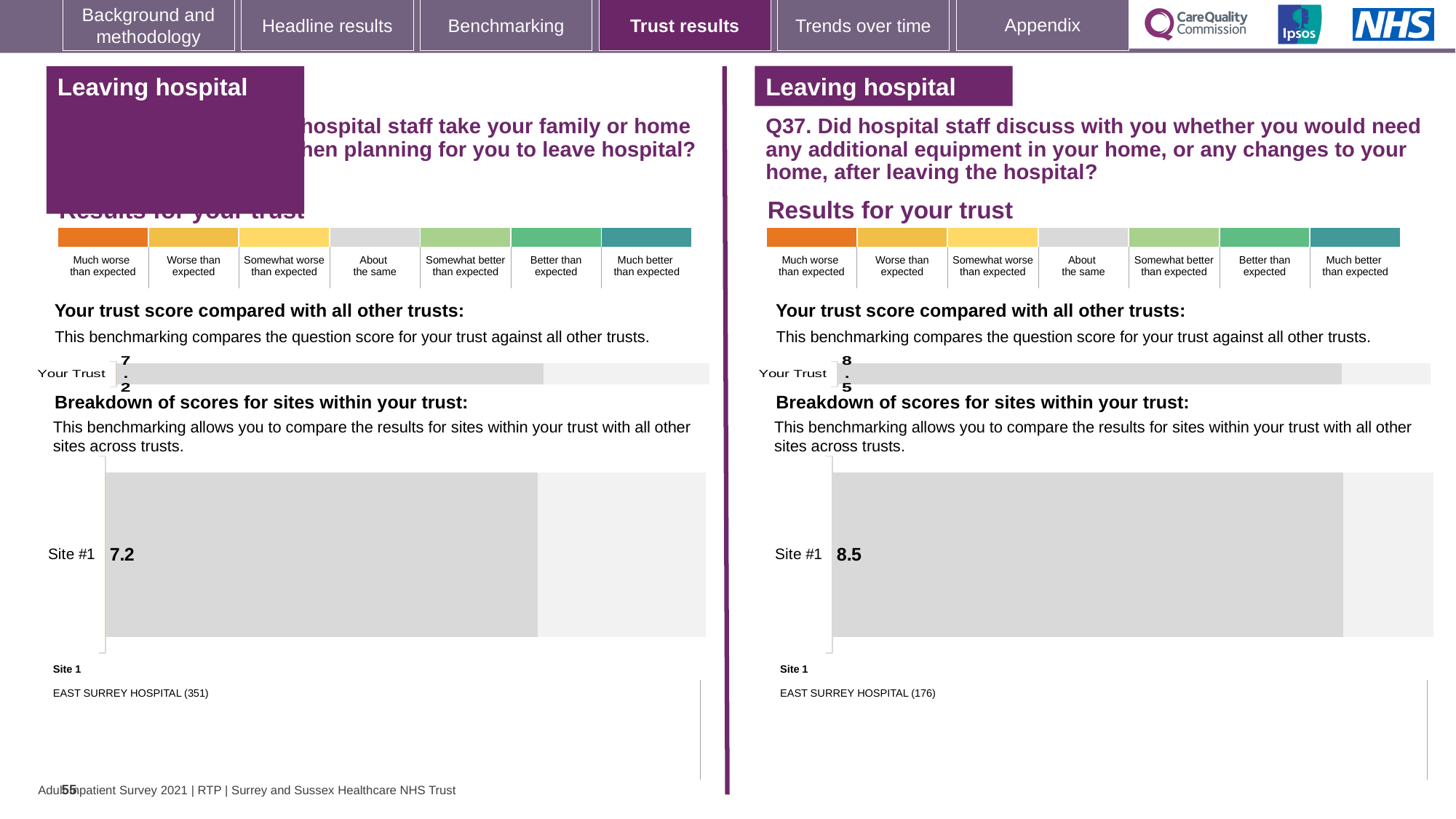
On the left-hand chart, what is the score shown for Site #1? 7.2 Which is larger: the Site #1 score on the left-hand chart or the Site #1 score on the right-hand chart (Q37)? Right-hand chart (Q37) On the left-hand chart, which site is listed as Site 1? EAST SURREY HOSPITAL (351) What is the difference between the Site #1 score on the right-hand chart (Q37) and the Site #1 score on the left-hand chart? 1.3 On the right-hand chart (Q37), what is the score shown for Your Trust? 8.5 On the right-hand chart (Q37), what is the score shown for Site #1? 8.5 On the right-hand chart (Q37), which site is listed as Site 1? EAST SURREY HOSPITAL (176) What kind of chart is used to show the Site #1 score on the left-hand side? Bar chart How many sites are shown in the site breakdown chart on the right-hand side (Q37)? 1 On the left-hand chart, what is the score shown for Your Trust? 7.2